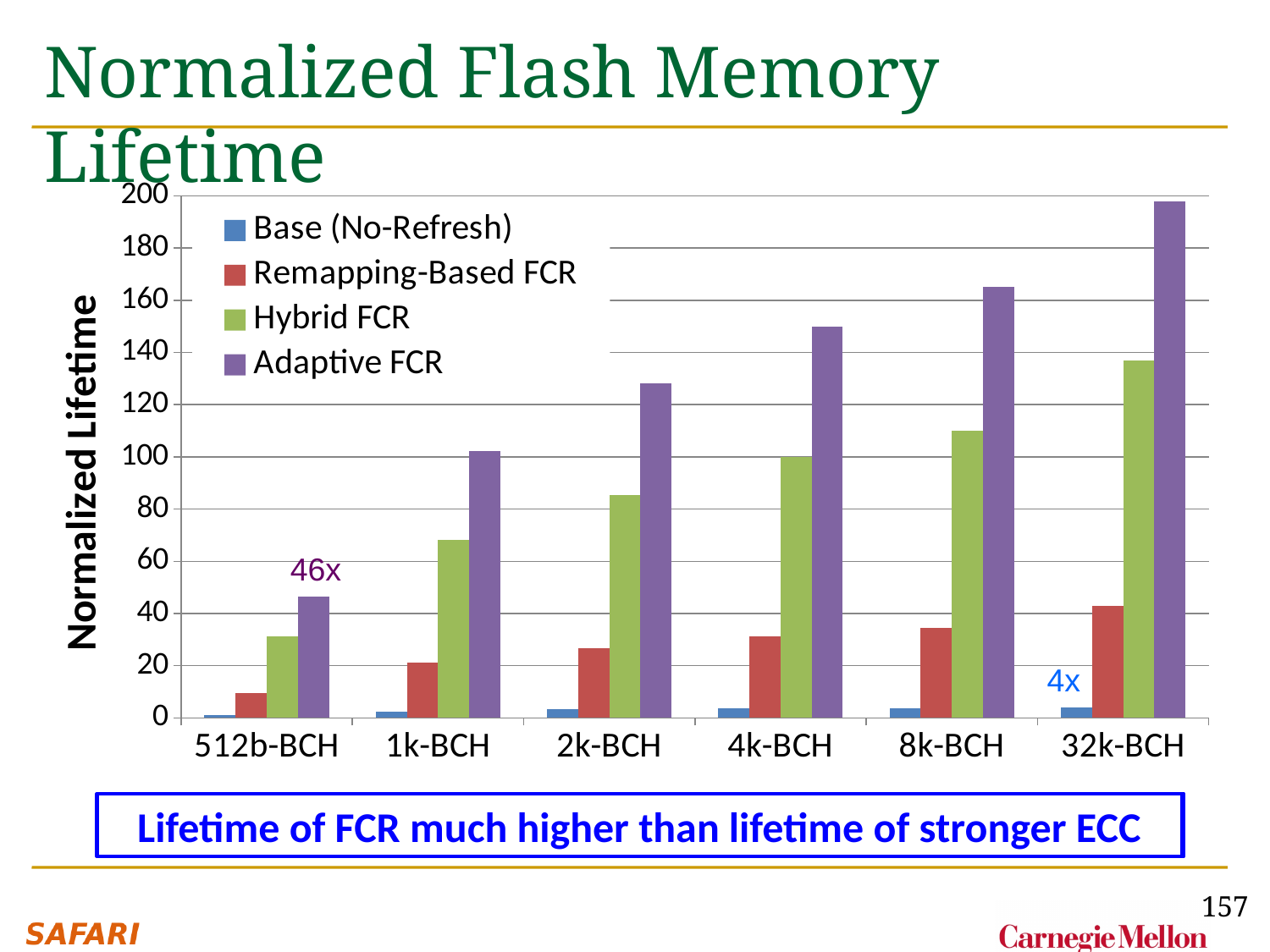
Which series has the lowest value at 4k-BCH? Base (No-Refresh) What kind of chart is shown on the slide? bar chart How many series does the legend list? 4 Is the Adaptive FCR value for 32k-BCH greater or less than 180? greater How many ECC categories are shown along the x axis? 6 At 2k-BCH, which is larger: Hybrid FCR or Remapping-Based FCR? Hybrid FCR Which series has the highest value at 32k-BCH? Adaptive FCR Is the Hybrid FCR value for 512b-BCH greater or less than 40? less Is the Adaptive FCR value for 8k-BCH greater or less than 140? greater What is the label on the y axis? Normalized Lifetime Do the Adaptive FCR values rise or fall from 512b-BCH to 32k-BCH? rise